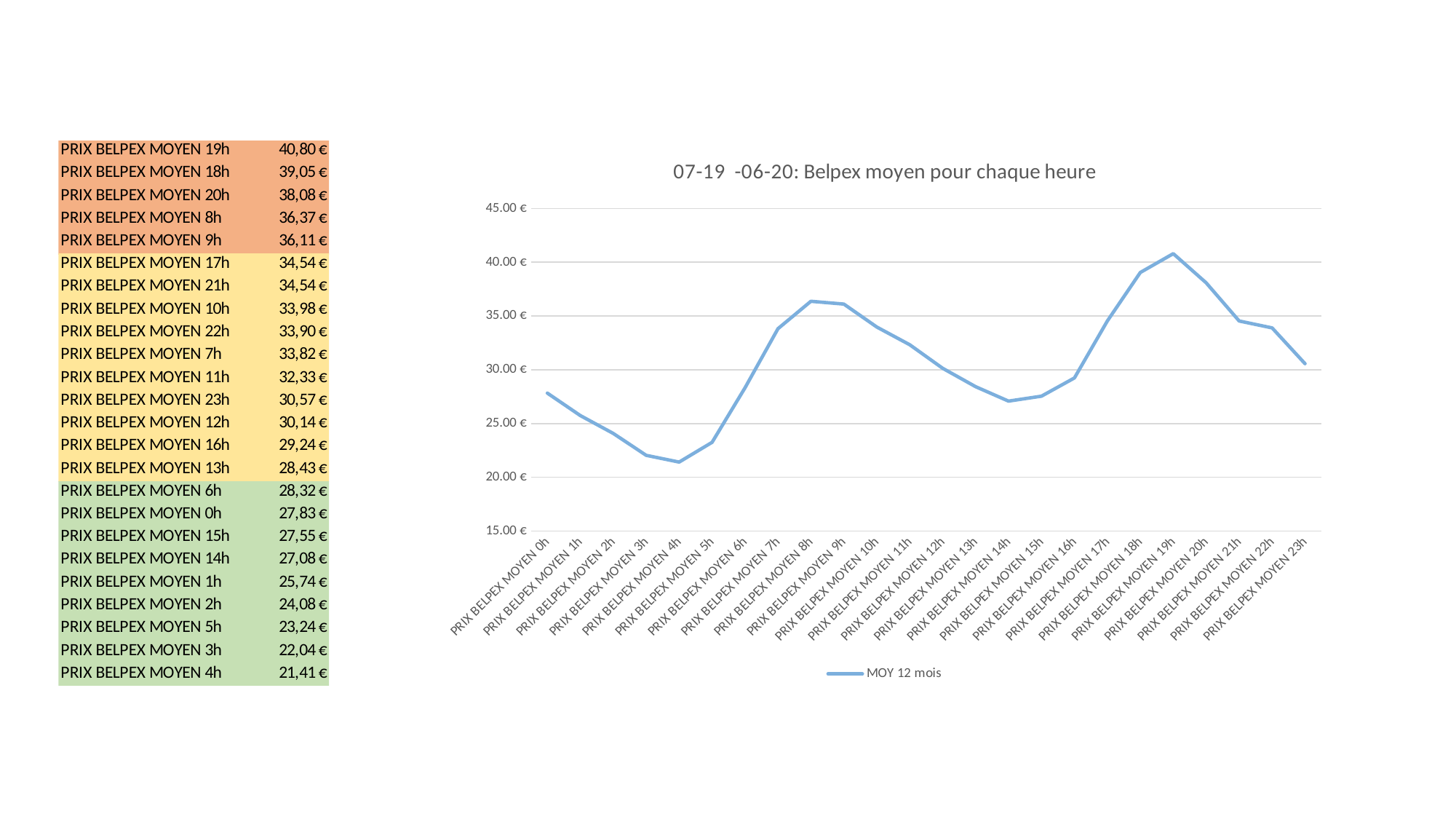
What is the title of the chart? 07-19 -06-20: Belpex moyen pour chaque heure Which is larger, the value for PRIX BELPEX MOYEN 9h or PRIX BELPEX MOYEN 12h? PRIX BELPEX MOYEN 9h How many hourly categories are plotted along the x axis of the chart? 24 Which hour has the lowest average Belpex price? PRIX BELPEX MOYEN 4h What is the name of the series in the chart legend? MOY 12 mois What is the value for PRIX BELPEX MOYEN 8h? 36,37 € How many series does the chart legend list? 1 What type of chart is shown on the slide? line chart Which hour has the highest average Belpex price? PRIX BELPEX MOYEN 19h Is the value for PRIX BELPEX MOYEN 18h greater or less than 35.00 €? greater What is the value for PRIX BELPEX MOYEN 14h? 27,08 € What is the difference between the values for PRIX BELPEX MOYEN 19h and PRIX BELPEX MOYEN 4h? 19,39 €